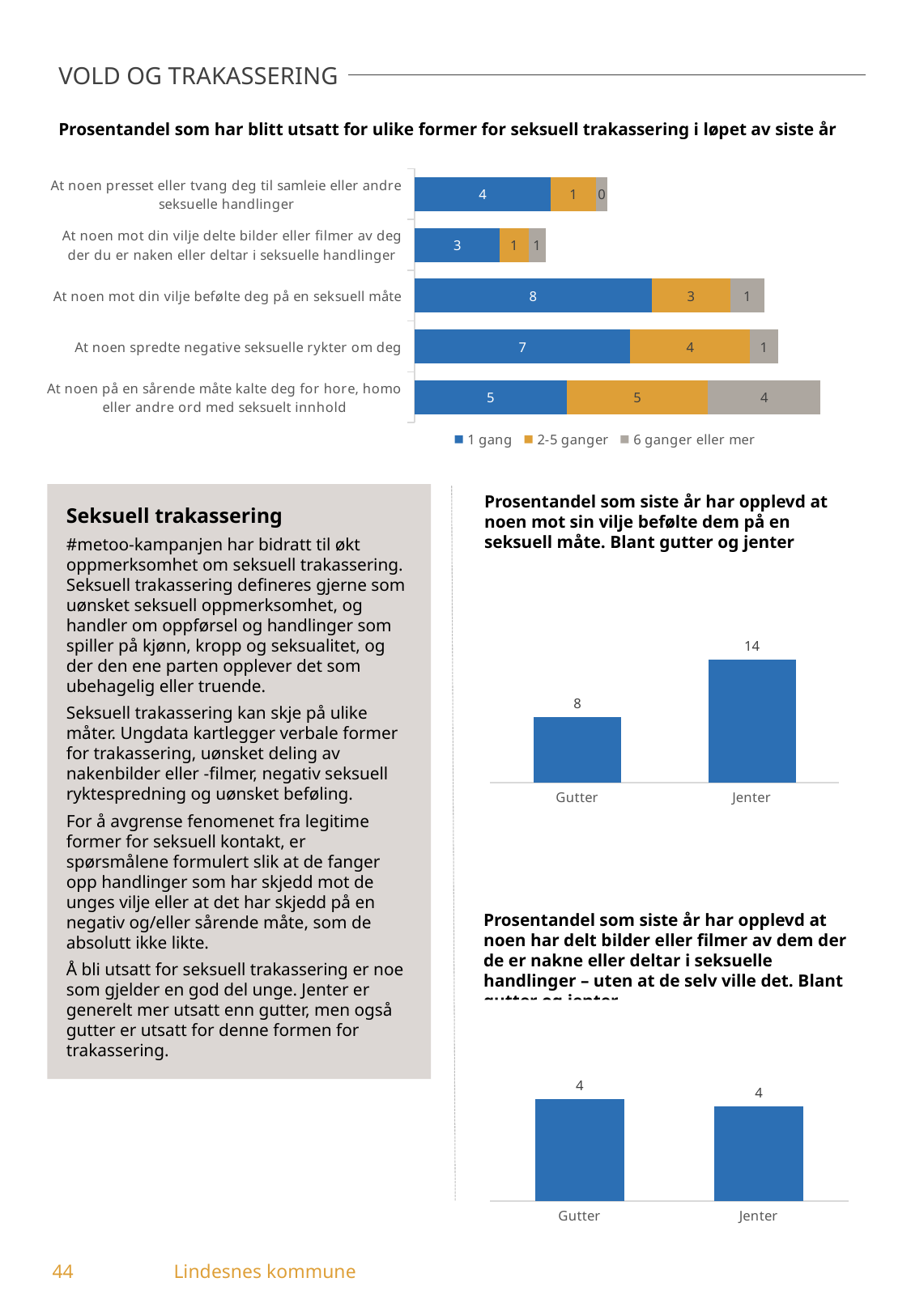
How many categories are shown in the top stacked bar chart? 5 In the top stacked bar chart, what is the total of the bar for 'At noen presset eller tvang deg til samleie eller andre seksuelle handlinger'? 5 In the top stacked bar chart, which category has the highest '1 gang' value? At noen mot din vilje befølte deg på en seksuell måte In the bottom chart about delte bilder eller filmer, which is larger, Gutter or Jenter? They are equal (4) In the top stacked bar chart, what is the difference between the '2-5 ganger' values for 'At noen spredte negative seksuelle rykter om deg' and 'At noen mot din vilje delte bilder eller filmer av deg der du er naken eller deltar i seksuelle handlinger'? 3 In the chart titled 'Prosentandel som siste år har opplevd at noen mot sin vilje befølte dem på en seksuell måte', what is the difference between Jenter and Gutter? 6 In the top stacked bar chart, what is the value of '1 gang' for 'At noen mot din vilje befølte deg på en seksuell måte'? 8 In the top stacked bar chart, what is the total of the bar for 'At noen spredte negative seksuelle rykter om deg'? 12 What kind of chart is the chart at the bottom right of the slide? Bar chart In the top stacked bar chart, what is the value of '6 ganger eller mer' for 'At noen på en sårende måte kalte deg for hore, homo eller andre ord med seksuelt innhold'? 4 In the chart titled 'Prosentandel som siste år har opplevd at noen mot sin vilje befølte dem på en seksuell måte', what is the value for Jenter? 14 How many series does the legend of the top stacked bar chart list? 3